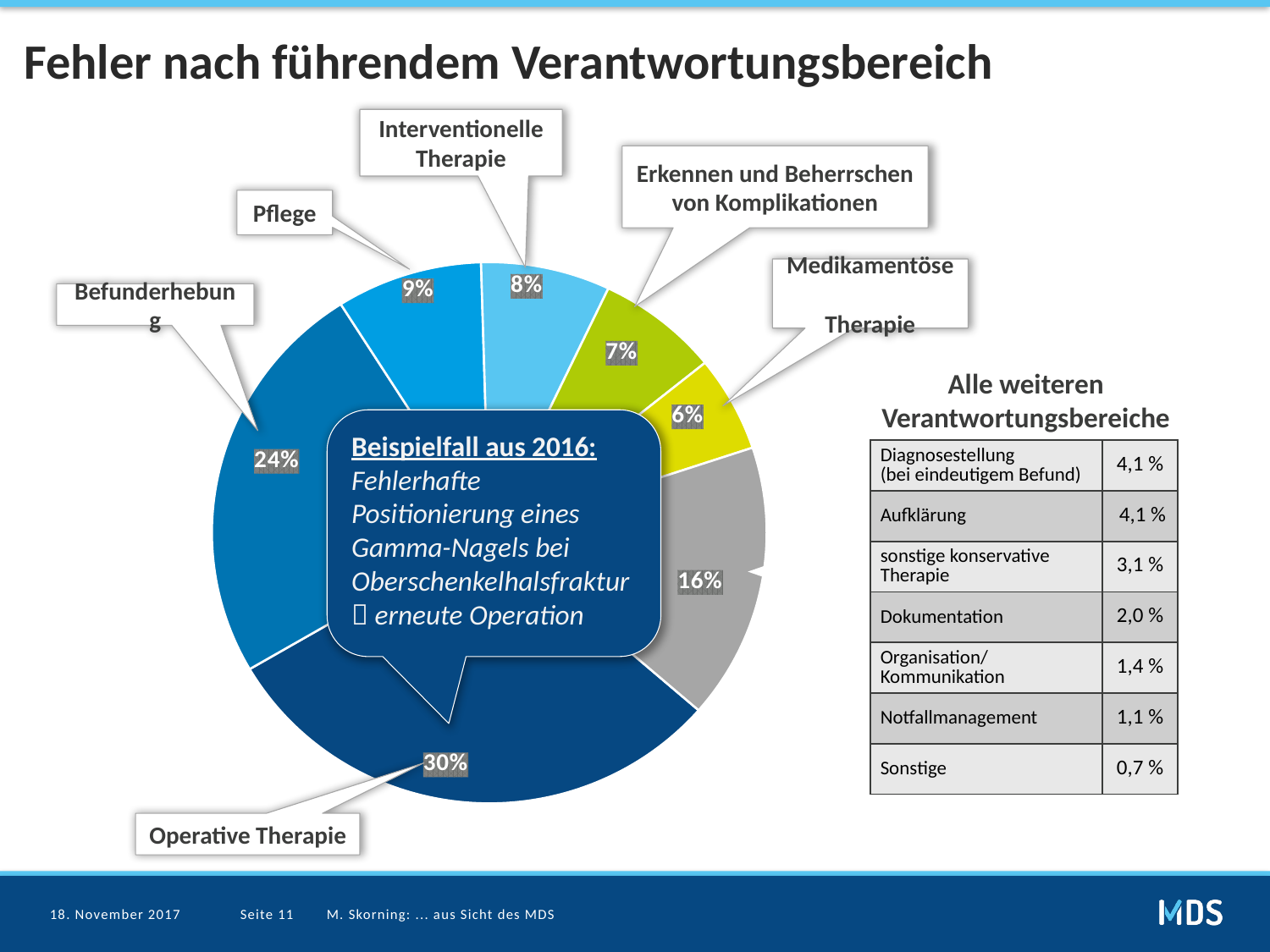
What share of errors is attributed to Operative Therapie? 30% What share of errors is attributed to Medikamentöse Therapie? 6% What share of errors is attributed to Pflege? 9% What is the title of the slide containing the pie chart? Fehler nach führendem Verantwortungsbereich Which labelled responsibility area has the smallest slice of the pie? Medikamentöse Therapie What is the difference in percentage points between Operative Therapie and Befunderhebung? 6 What kind of chart is shown on the slide? pie chart What share of errors is attributed to Interventionelle Therapie? 8% What share of errors is attributed to Erkennen und Beherrschen von Komplikationen? 7% Which responsibility area has the largest slice of the pie? Operative Therapie Which has a larger share, Pflege or Interventionelle Therapie? Pflege What share of errors is attributed to Befunderhebung? 24%